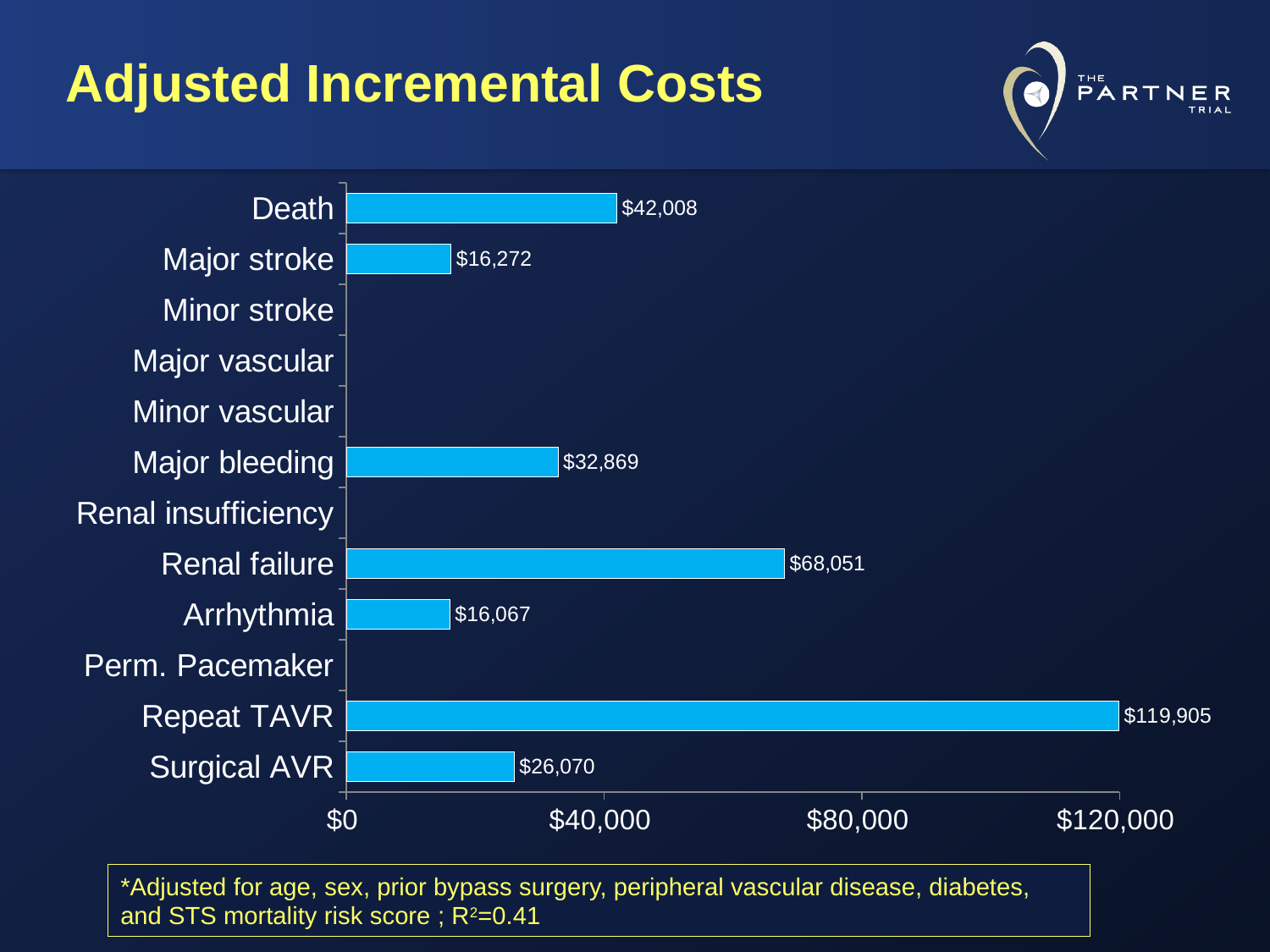
What is the adjusted incremental cost for Renal failure? $68,051 What is the adjusted incremental cost for Surgical AVR? $26,070 Which category has the highest adjusted incremental cost? Repeat TAVR Is the value for Death greater or less than $40,000? greater Which has a larger adjusted incremental cost, Major bleeding or Surgical AVR? Major bleeding What is the adjusted incremental cost for Death? $42,008 What is the difference between the costs for Death and Major stroke? $25,736 What is the title of the slide? Adjusted Incremental Costs What is the adjusted incremental cost for Repeat TAVR? $119,905 How many categories are listed on the vertical axis of the chart? 12 What is the difference between the costs for Repeat TAVR and Renal failure? $51,854 What kind of chart is shown on the slide? Bar chart